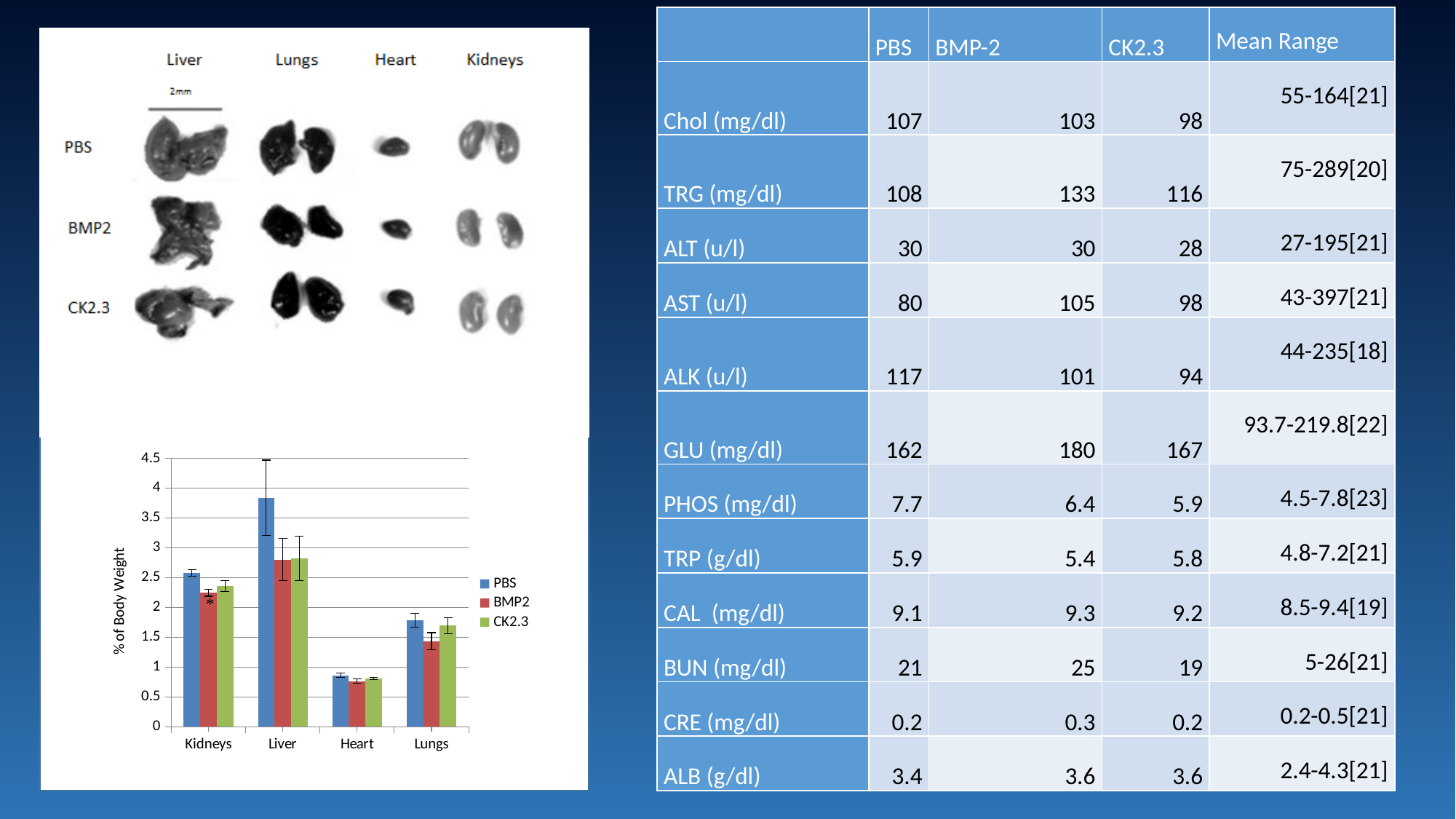
What is the label of the y axis of the bar chart? % of Body Weight What kind of chart is shown at the bottom left of the slide? bar chart How many organ categories are shown on the x axis of the bar chart? 4 In the bar chart, is the PBS value for Liver greater or less than 3.5? greater In the bar chart, for Kidneys, which is larger: the PBS value or the BMP2 value? PBS In the bar chart, which organ has the lowest % of body weight across all series? Heart In the bar chart, is the PBS value for Heart greater or less than 1? less How many series does the legend of the bar chart list? 3 In the bar chart, is the PBS value for Lungs greater or less than 1.5? greater In the bar chart, which organ has the highest % of body weight for the PBS series? Liver Which series are listed in the legend of the bar chart? PBS, BMP2, CK2.3